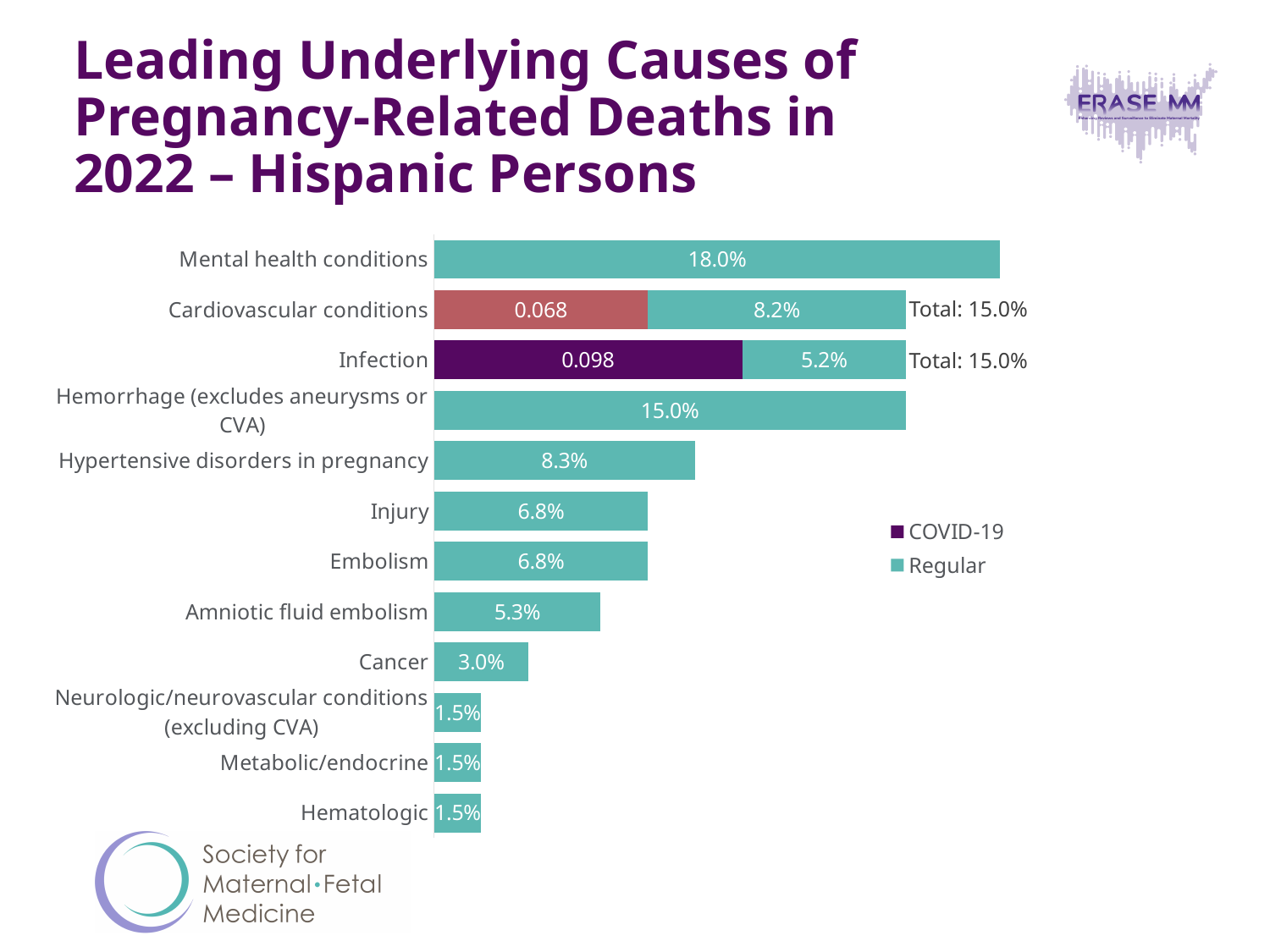
What is the COVID-19 value for Infection? 0.098 What kind of chart is shown on the slide? bar chart Which cause has the highest value on the chart? Mental health conditions What is the value for Mental health conditions? 18.0% What is the value for Amniotic fluid embolism? 5.3% What is the Regular value for Cardiovascular conditions? 8.2% How many causes of death are listed on the chart? 12 What are the two entries in the chart legend? COVID-19 and Regular What is the difference between the values for Hypertensive disorders in pregnancy and Cancer? 5.3% Which is larger, the value for Hemorrhage (excludes aneurysms or CVA) or for Hypertensive disorders in pregnancy? Hemorrhage (excludes aneurysms or CVA) What is the total shown for the Cardiovascular conditions bar? 15.0% How many series does the legend list? 2